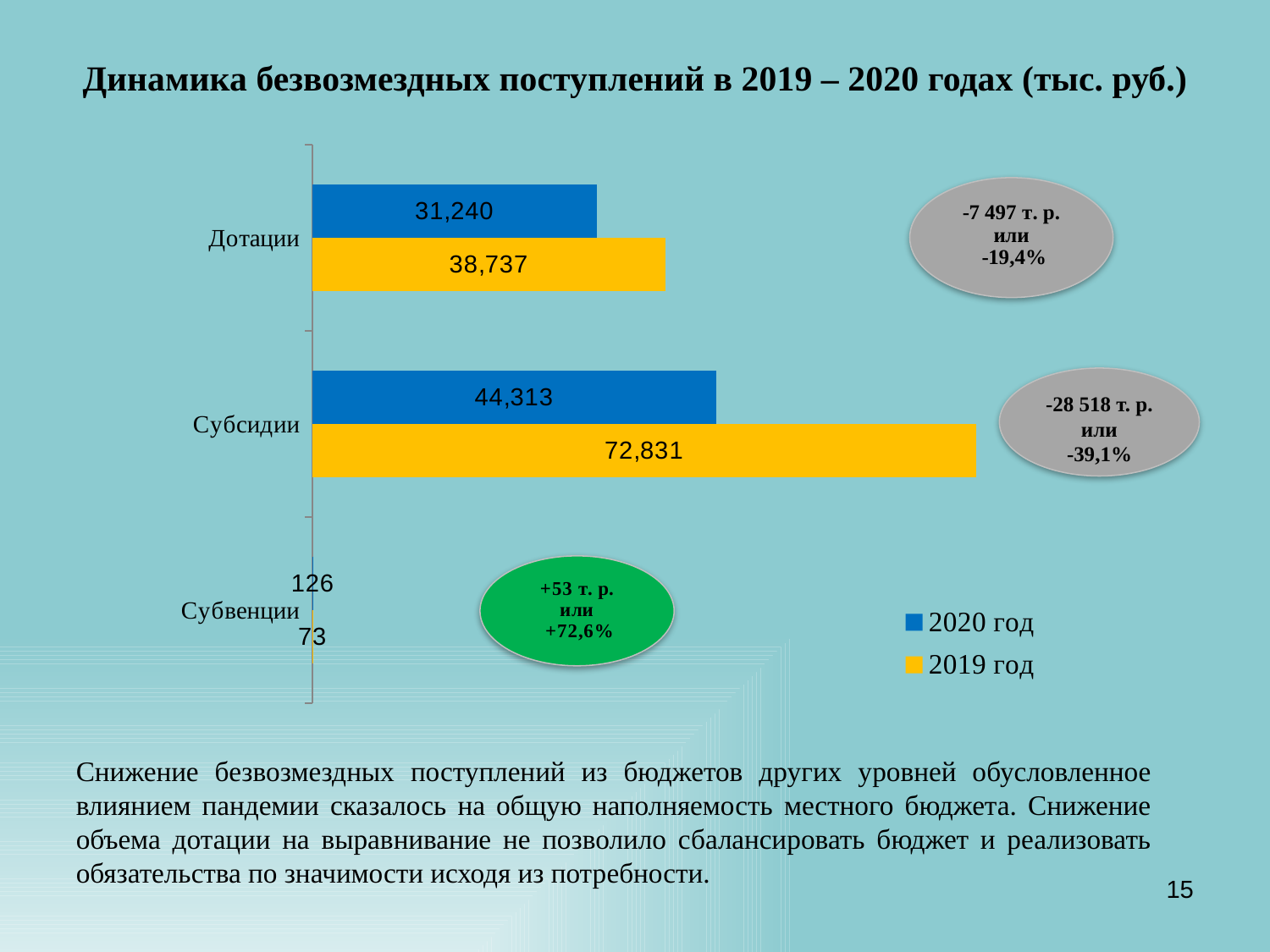
What is the value for Дотации in the 2020 год series? 31,240 Which category has the highest value in the 2019 год series? Субсидии What is the value for Субсидии in the 2020 год series? 44,313 What is the value for Субвенции in the 2019 год series? 73 What is the value for Субсидии in the 2019 год series? 72,831 How many categories are shown on the chart? 3 Which is larger for Субвенции: the 2020 год value or the 2019 год value? 2020 год How many series does the legend list? 2 Which category has the lowest value in the 2020 год series? Субвенции What is the difference between the 2019 год and 2020 год values for Субсидии? 28,518 What is the value for Дотации in the 2019 год series? 38,737 What type of chart is shown on the slide? bar chart